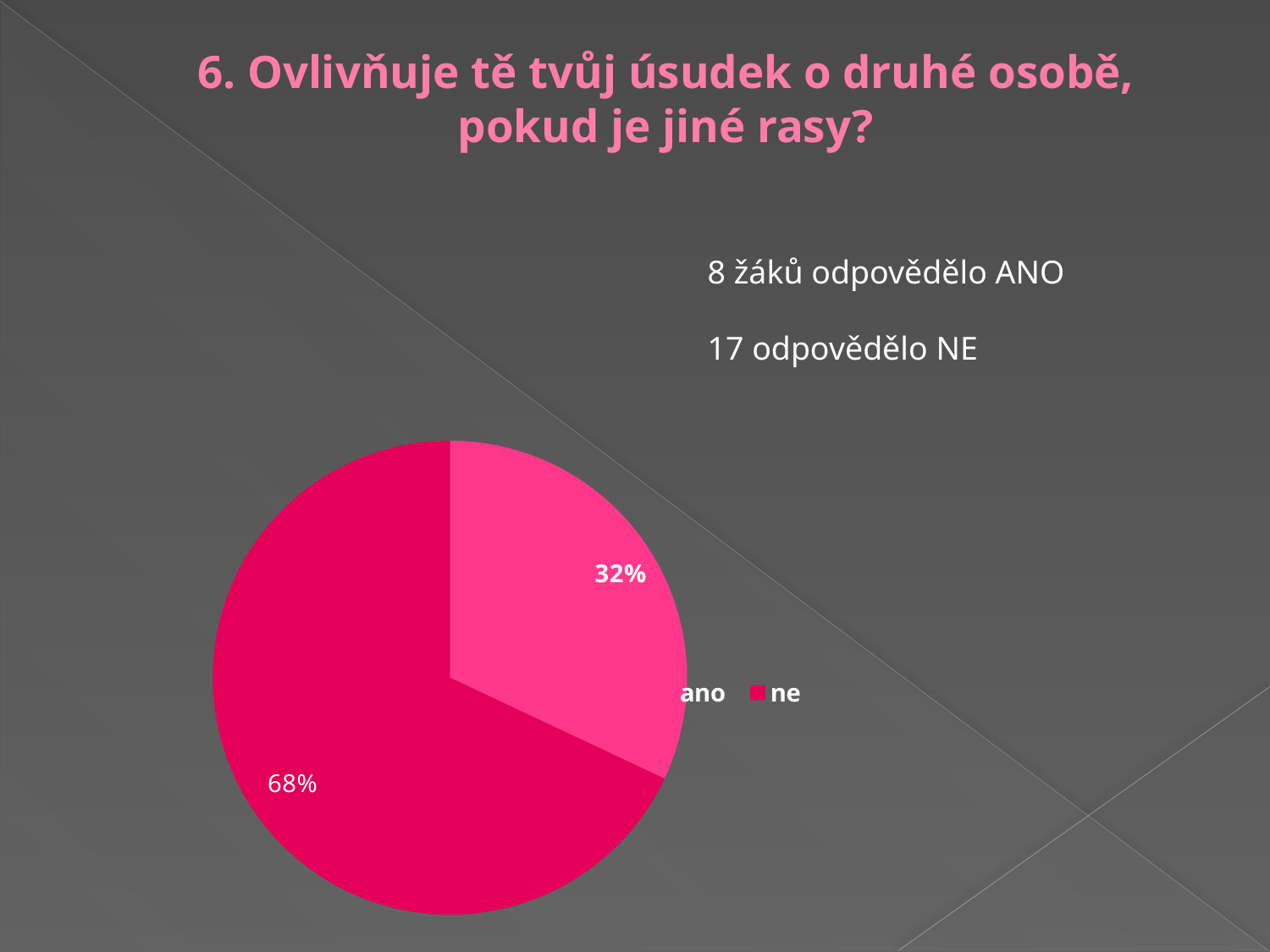
What kind of chart is shown on the slide? pie chart What share of the pie does the "ano" slice represent? 32% Which slice of the pie is the smallest? ano Which slice of the pie is the largest? ne What is the difference in percentage points between the "ne" slice and the "ano" slice? 36 How many entries does the legend list? 2 What share of the pie does the "ne" slice represent? 68% Which is larger, the "ano" slice or the "ne" slice? ne How many slices does the pie chart have? 2 What are the two legend entries of the pie chart? ano, ne Is the share of the "ne" slice greater or less than 50%? greater